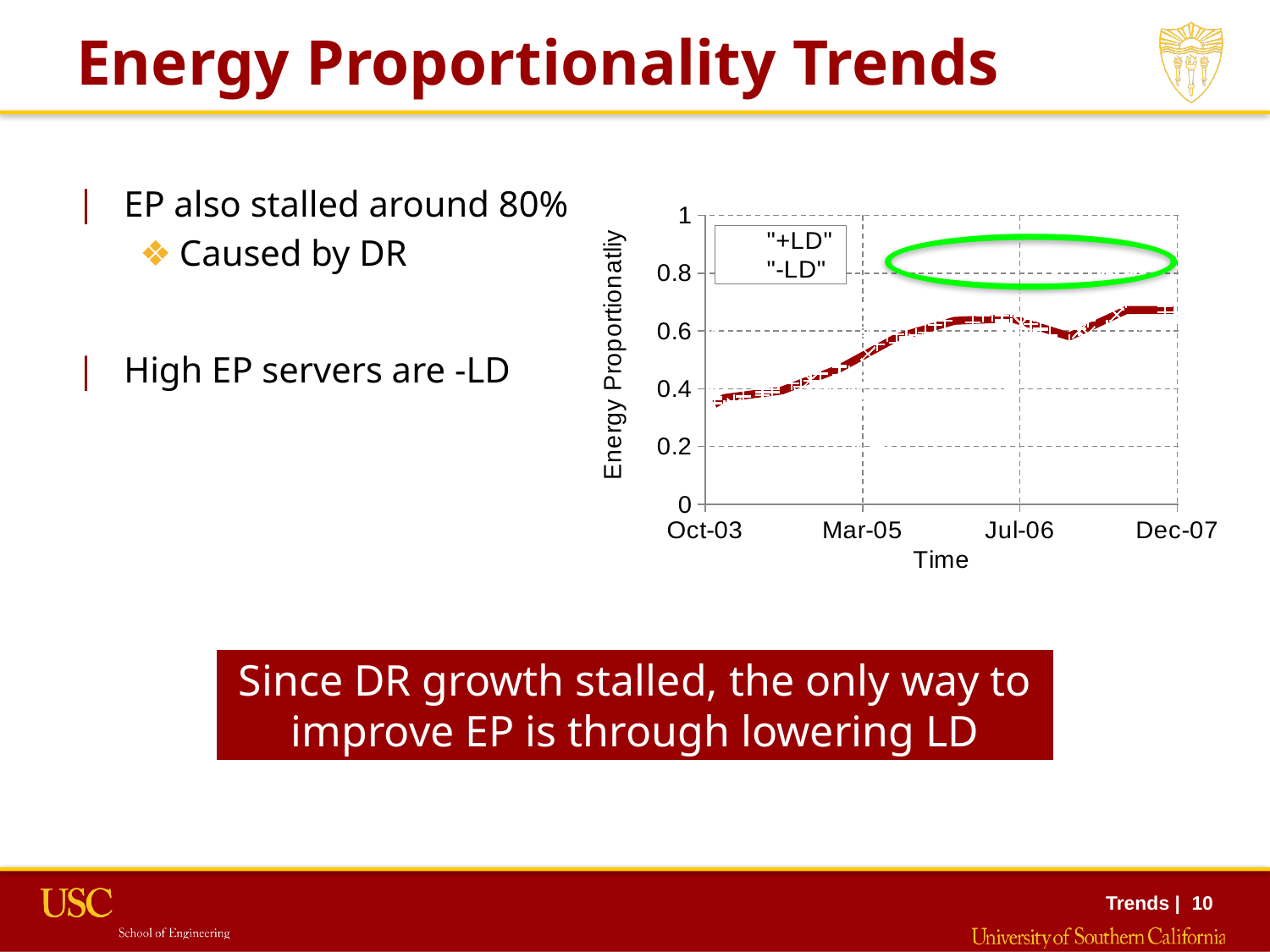
How many tick labels are shown on the chart's x-axis? 4 Which is larger, the value at Dec-07 or the value at Oct-03? Dec-07 How many series does the chart's legend list? 2 Is the value of the lines at Oct-03 greater or less than 0.6? less What kind of chart is shown on the slide? line chart Is the value of the lines at Mar-05 greater or less than 0.8? less Is the value of the lines at Dec-07 greater or less than 0.8? less What are the two series named in the chart's legend? "+LD" and "-LD" What is the highest value shown on the chart's y-axis? 1 Do the plotted values generally rise or fall from Oct-03 to Dec-07? rise What is the label of the chart's y-axis? Energy Proportionatliy